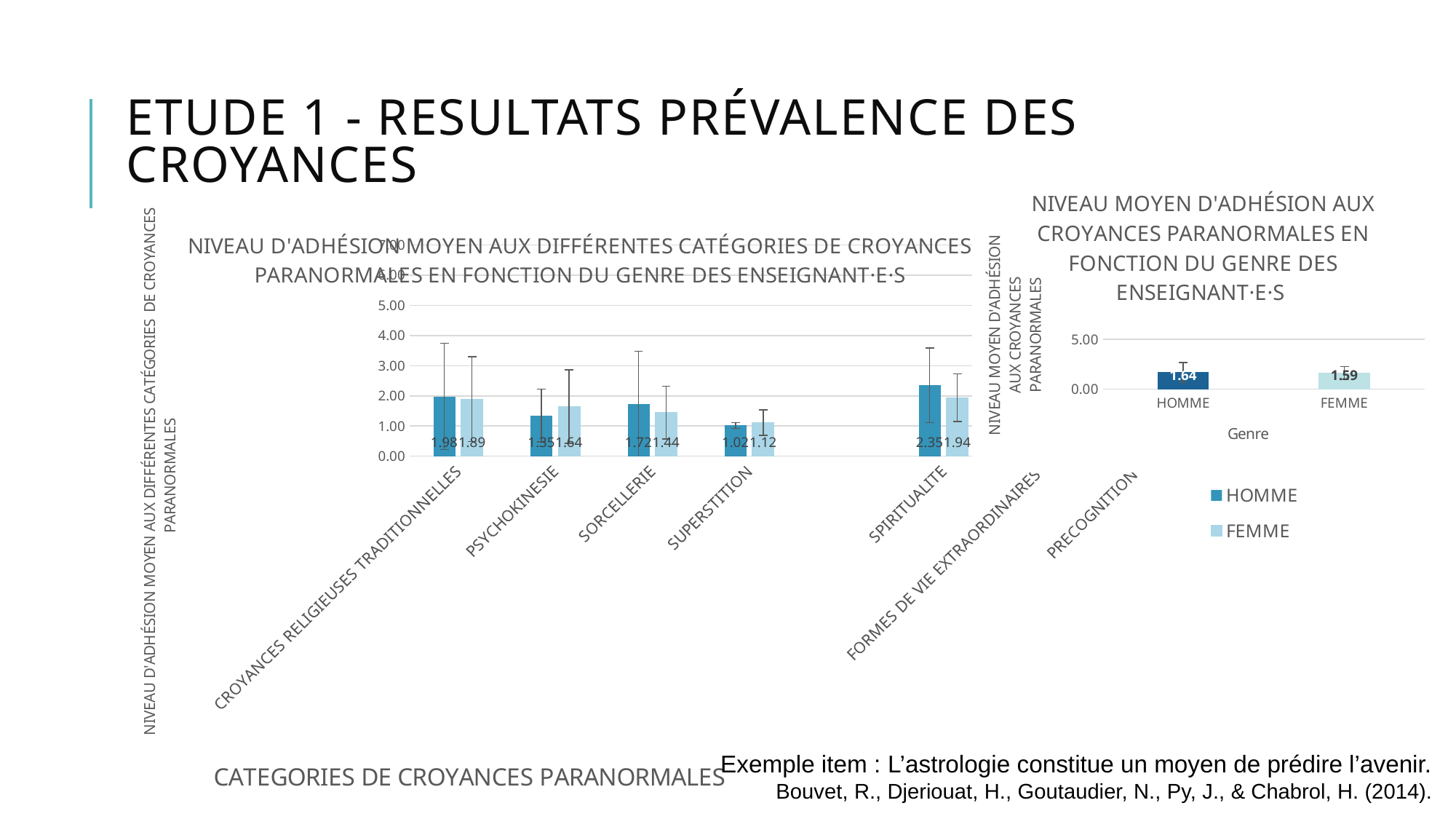
In the chart on the left, what is the HOMME value for Superstition? 1.02 In the chart on the right, what is the difference between the HOMME and FEMME values? 0.05 In the chart on the left, what is the FEMME value for Psychokinesie? 1.64 In the chart on the left (Niveau d'adhésion moyen aux différentes catégories de croyances paranormales), what is the HOMME value for Croyances religieuses traditionnelles? 1.98 How many series does the legend list for the chart on the left? 2 In the chart on the right, what is the value for FEMME? 1.59 In the chart on the right (Niveau moyen d'adhésion aux croyances paranormales en fonction du genre), what is the value for HOMME? 1.64 In the chart on the right, which category has the higher value, HOMME or FEMME? HOMME In the chart on the right, how many categories are shown on the x axis? 2 What kind of chart is the chart on the right? Bar chart In the chart on the left, what is the FEMME value for Croyances religieuses traditionnelles? 1.89 In the chart on the left, what is the difference between the HOMME and FEMME values for Croyances religieuses traditionnelles? 0.09